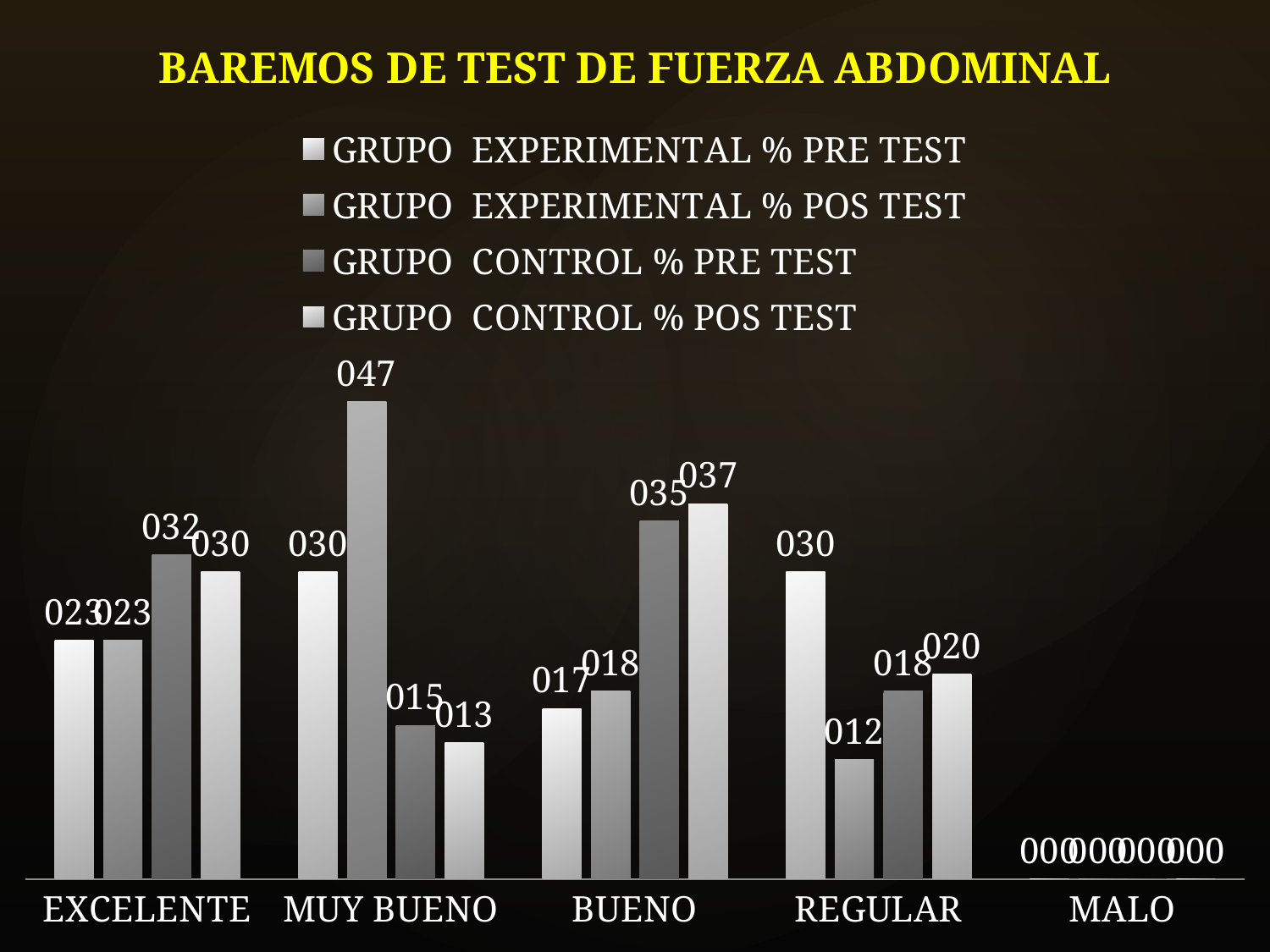
What is the title of the chart? BAREMOS DE TEST DE FUERZA ABDOMINAL What is the difference between GRUPO EXPERIMENTAL % POS TEST and GRUPO CONTROL % POS TEST in the MUY BUENO category? 034 How many series does the legend list? 4 Which category has the highest value for GRUPO EXPERIMENTAL % POS TEST? MUY BUENO In the BUENO category, which is larger: GRUPO CONTROL % PRE TEST or GRUPO EXPERIMENTAL % PRE TEST? GRUPO CONTROL % PRE TEST What is the value for GRUPO EXPERIMENTAL % POS TEST in the MUY BUENO category? 047 Which category has the lowest value for GRUPO CONTROL % POS TEST? MALO What kind of chart is shown on the slide? Bar chart What is the value for GRUPO EXPERIMENTAL % POS TEST in the REGULAR category? 012 How many categories are shown on the x axis? 5 What is the value for GRUPO CONTROL % PRE TEST in the EXCELENTE category? 032 What is the value for GRUPO CONTROL % POS TEST in the BUENO category? 037